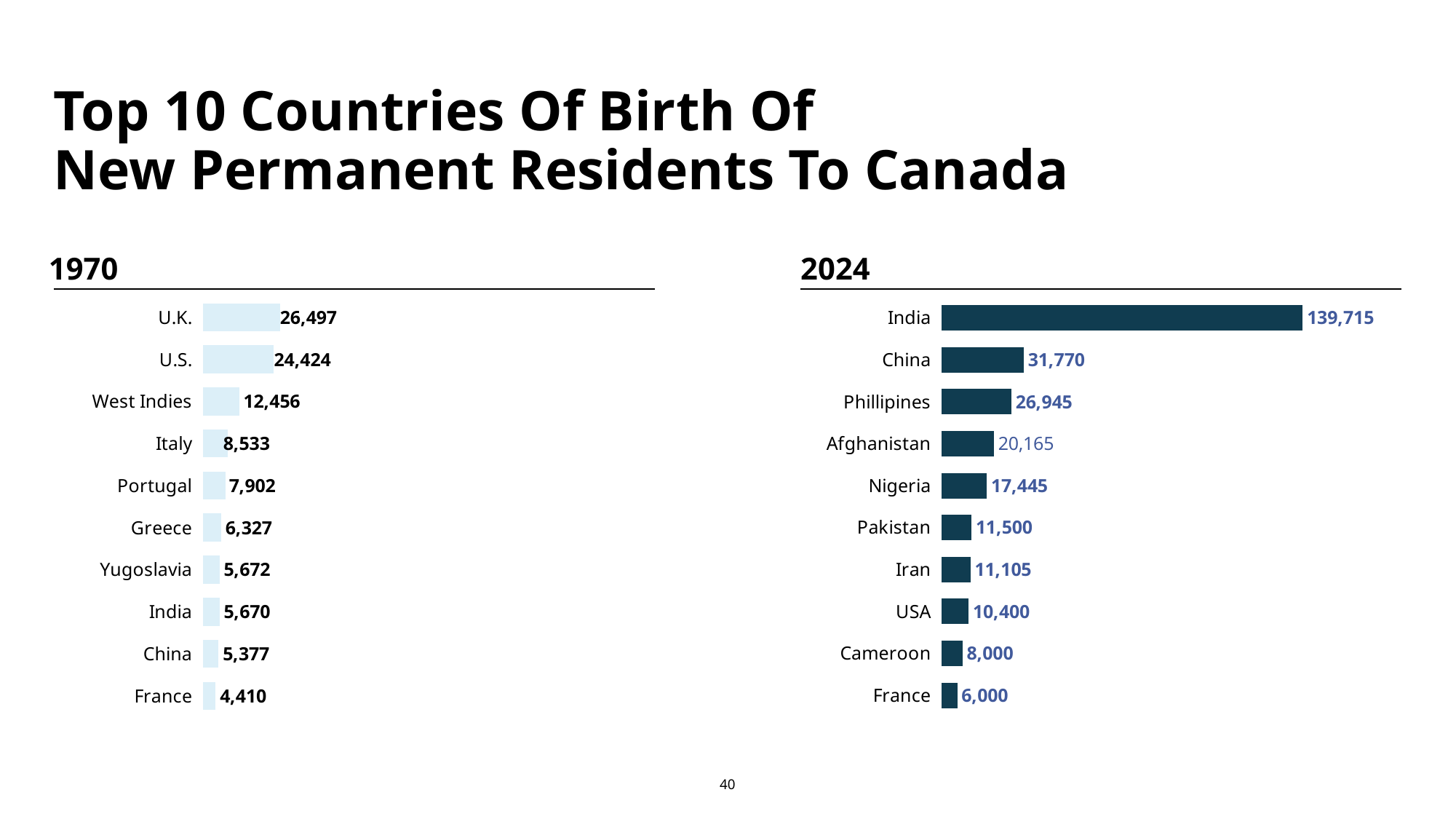
In the 1970 chart, what is the value for the U.K.? 26,497 In the 2024 chart, what is the value for Nigeria? 17,445 In the 1970 chart, what is the difference between the values for the U.K. and the U.S.? 2,073 In the 2024 chart, what is the value for France? 6,000 In the 2024 chart, which is larger, the value for Pakistan or the value for USA? Pakistan In the 1970 chart, which is larger, the value for Italy or the value for Portugal? Italy In the 2024 chart, what is the difference between the values for India and China? 107,945 In the 1970 chart, what is the value for India? 5,670 In the 2024 chart, which country has the highest value? India How many countries are shown in the 2024 chart? 10 In the 1970 chart, which country has the lowest value? France What kind of chart is the 1970 chart? Bar chart